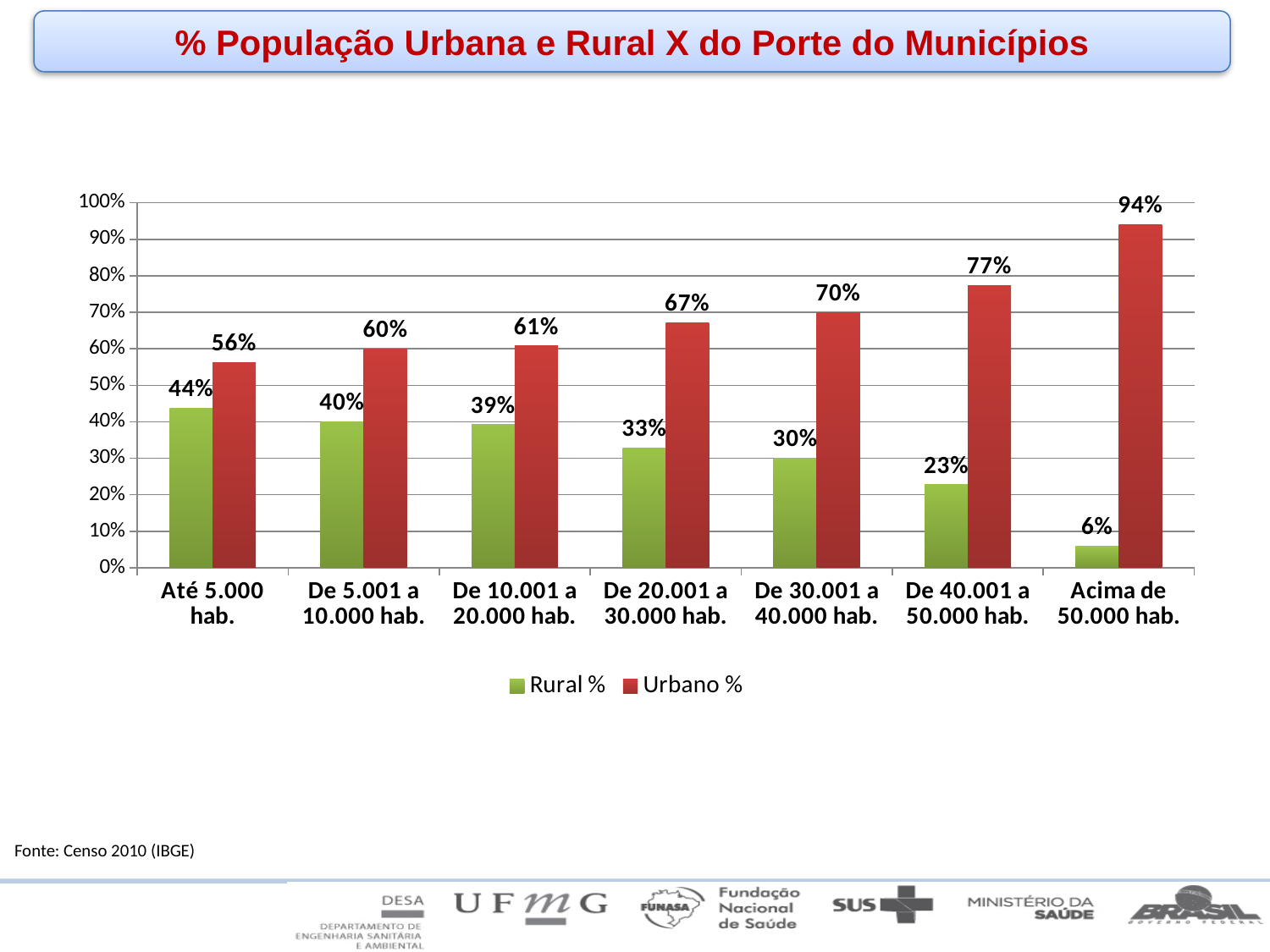
How many municipality size categories are shown on the x axis? 7 Which municipality size category has the lowest Rural % value? Acima de 50.000 hab. What kind of chart is shown on the slide? Bar chart Which is larger for 'De 5.001 a 10.000 hab.': the Rural % or the Urbano % value? Urbano % What colour are the Urbano % bars? Red Which municipality size category has the highest Urbano % value? Acima de 50.000 hab. What is the difference between the Urbano % and Rural % values for 'De 40.001 a 50.000 hab.'? 54% How many series does the legend list? 2 What is the Urbano % value for 'De 20.001 a 30.000 hab.'? 67% What is the Urbano % value for municipalities 'Acima de 50.000 hab.'? 94% What is the Rural % value for municipalities 'Até 5.000 hab.'? 44% Do the Rural % values rise or fall as municipality size increases along the x axis? Fall